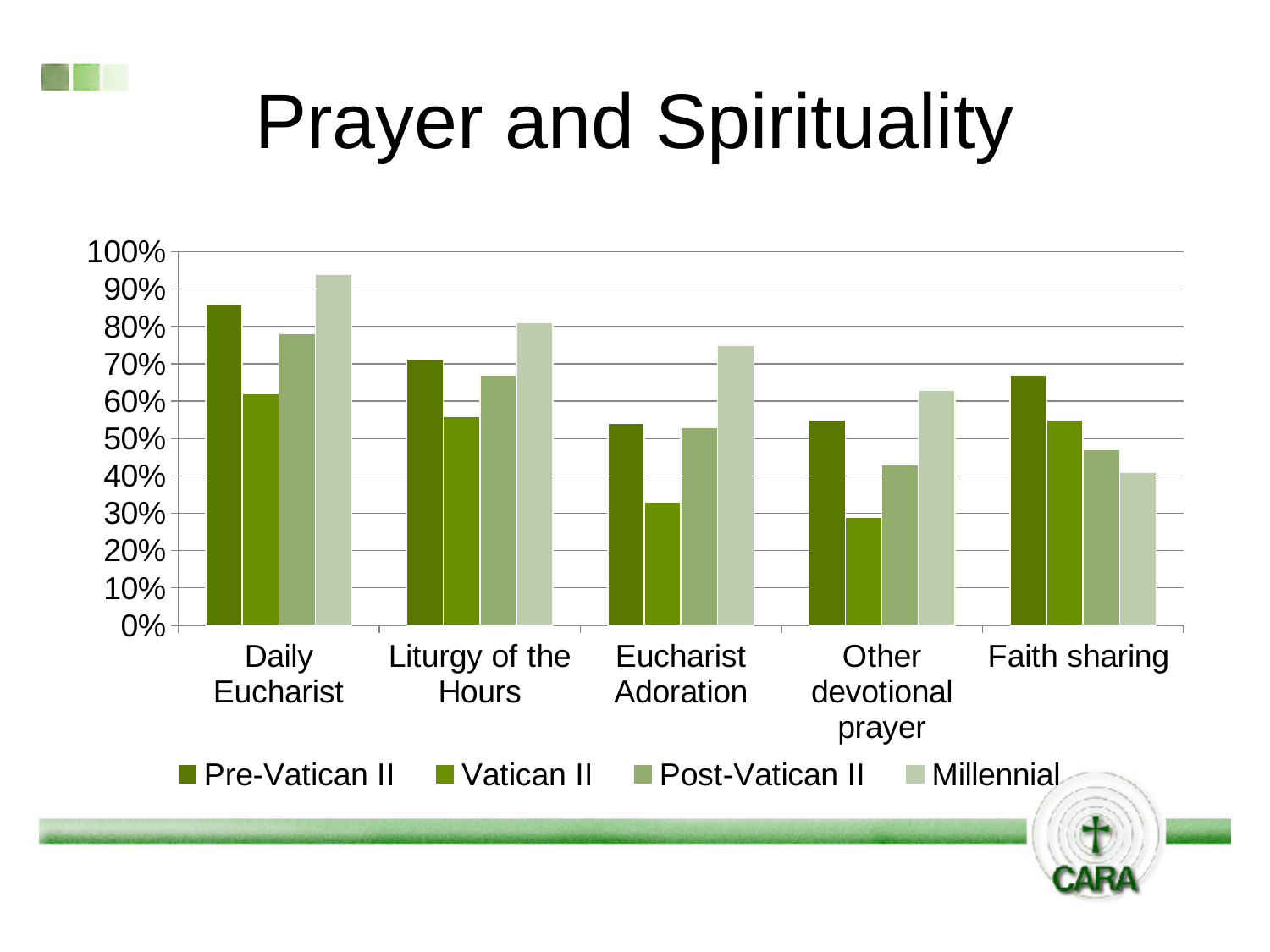
Is the Millennial value for Daily Eucharist greater or less than 90%? greater How many series does the legend list? 4 Which category has the highest Millennial bar? Daily Eucharist How many categories are shown on the x axis? 5 Is the Post-Vatican II value for Other devotional prayer greater or less than 50%? less What kind of chart is shown on the slide? bar chart Is the Vatican II value for Eucharist Adoration greater or less than 40%? less What is the title of the slide? Prayer and Spirituality Which category has the lowest Millennial bar? Faith sharing Which series has the highest bar for Faith sharing? Pre-Vatican II For Faith sharing, which is larger: the Pre-Vatican II value or the Millennial value? Pre-Vatican II For Daily Eucharist, which is larger: the Millennial value or the Pre-Vatican II value? Millennial